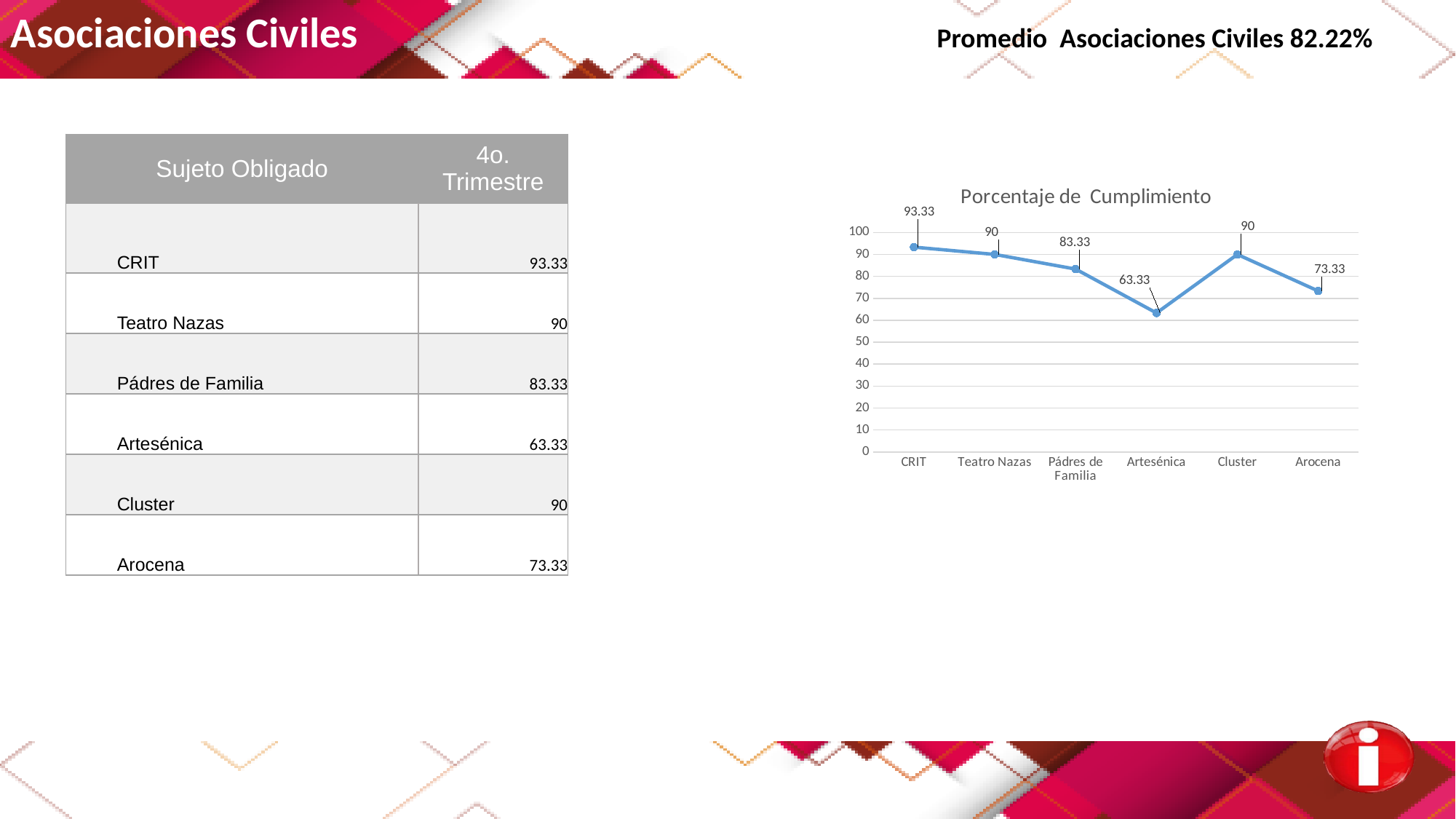
What is the title of the chart on the slide? Porcentaje de Cumplimiento What is the value for CRIT in the Porcentaje de Cumplimiento chart? 93.33 What is the difference between the values for CRIT and Artesénica in the Porcentaje de Cumplimiento chart? 30 What is the value for Artesénica in the Porcentaje de Cumplimiento chart? 63.33 What is the value for Arocena in the Porcentaje de Cumplimiento chart? 73.33 Which category has the lowest value in the Porcentaje de Cumplimiento chart? Artesénica Is the value for Arocena in the Porcentaje de Cumplimiento chart greater or less than 80? less Which category has the highest value in the Porcentaje de Cumplimiento chart? CRIT Which is larger in the Porcentaje de Cumplimiento chart, the value for Cluster or the value for Arocena? Cluster What is the value for Pádres de Familia in the Porcentaje de Cumplimiento chart? 83.33 How many categories are plotted in the Porcentaje de Cumplimiento chart? 6 What kind of chart is the Porcentaje de Cumplimiento chart? line chart